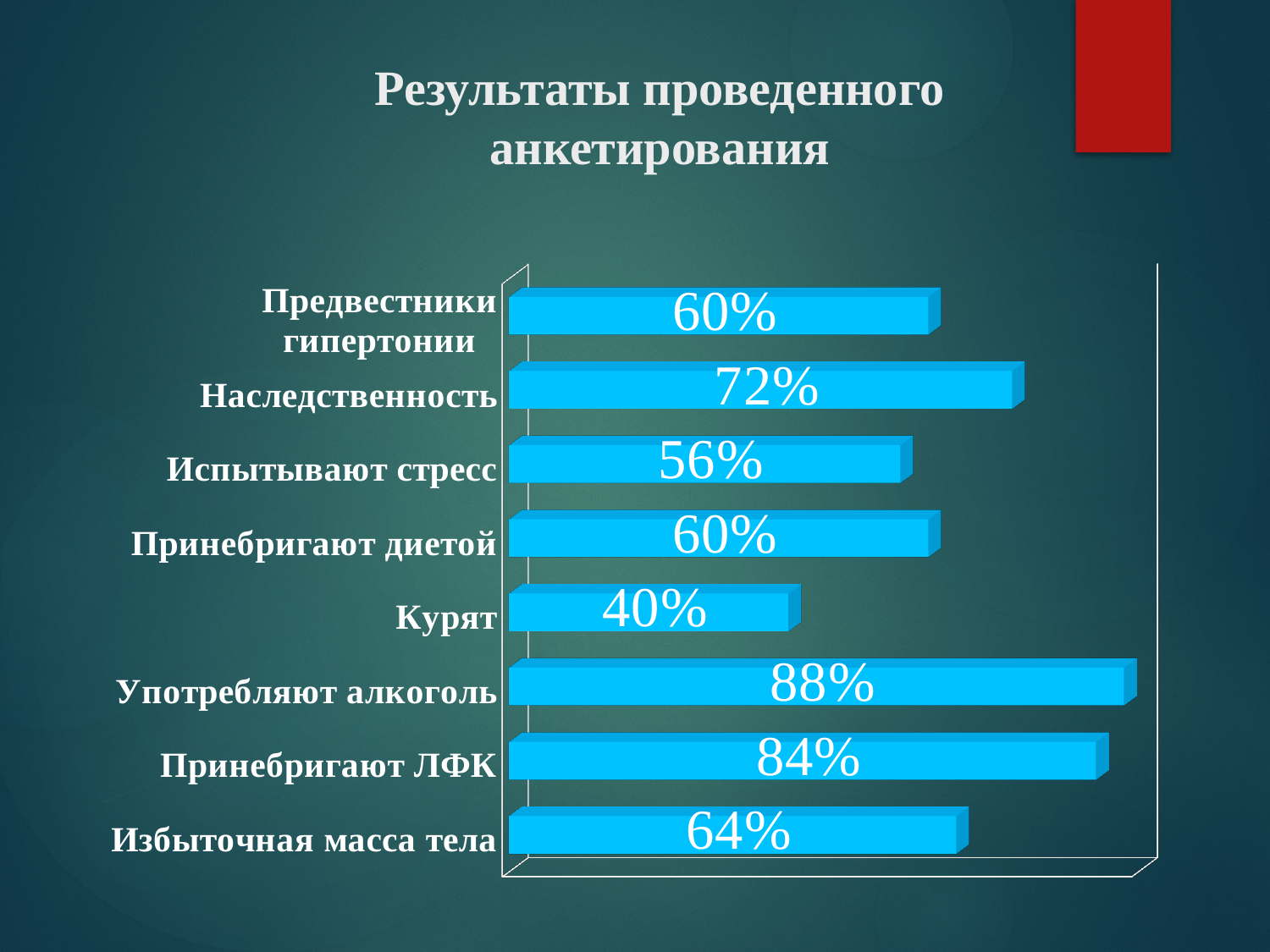
Which category has the lowest value? Курят What value is shown for Избыточная масса тела? 64% What kind of chart is shown on the slide? Bar chart What value is shown for Употребляют алкоголь? 88% What value is shown for Курят? 40% What is the difference between the values for Наследственность and Курят? 32% How many categories are shown in the chart? 8 Which category has the highest value? Употребляют алкоголь What is the difference between the values for Употребляют алкоголь and Принебригают ЛФК? 4% Which is larger, the value for Испытывают стресс or the value for Избыточная масса тела? Избыточная масса тела What value is shown for Наследственность? 72% What is the title of the slide? Результаты проведенного анкетирования